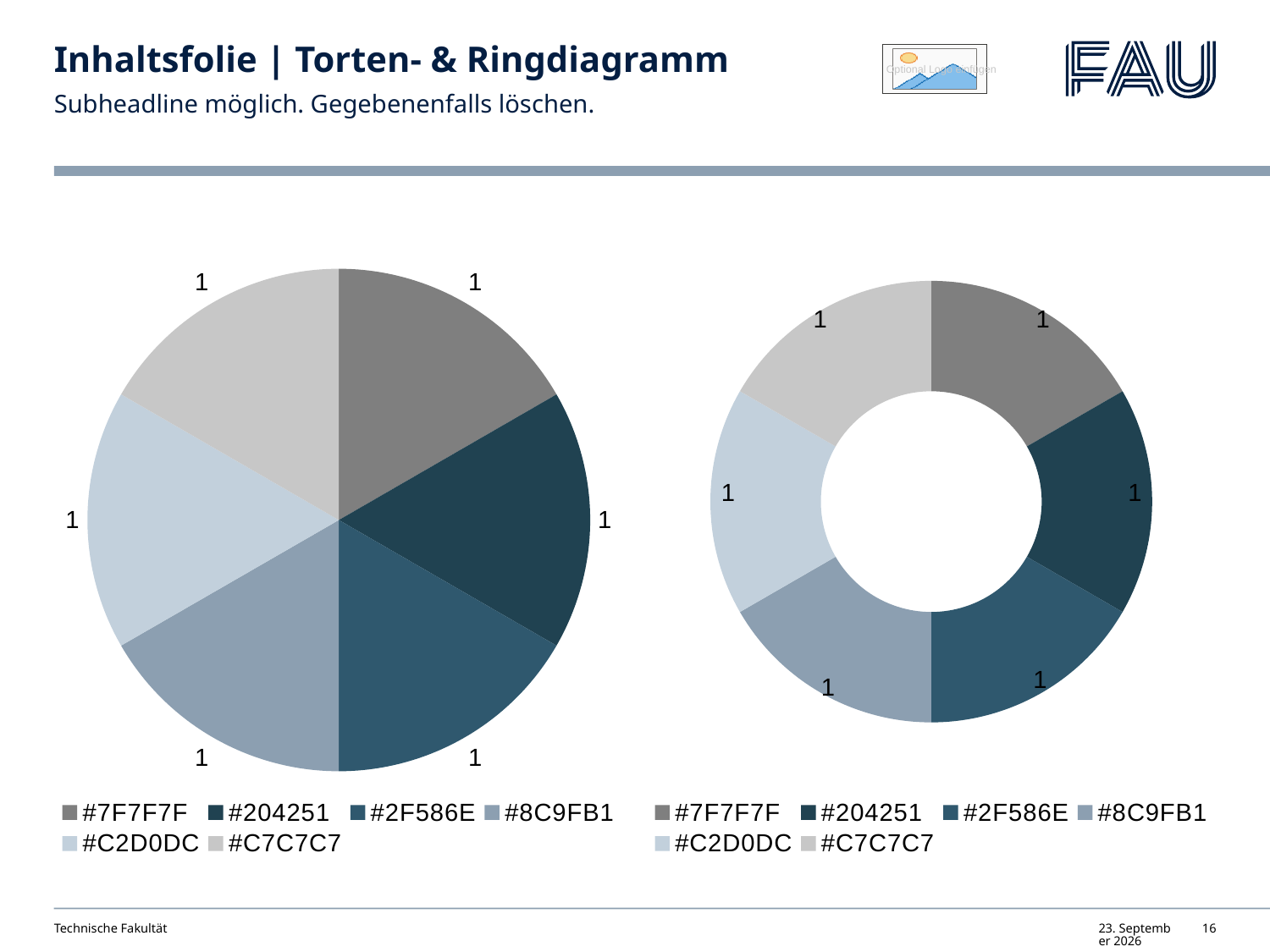
In the pie chart on the left, what is the value of the #204251 slice? 1 What kind of chart is the chart on the right of the slide? doughnut chart In the pie chart on the left, what is the total of all the slice values? 6 What kind of chart is the chart on the left of the slide? pie chart In the pie chart on the left, which legend entry is listed last? #C7C7C7 In the doughnut chart on the right, what is the value of the #C7C7C7 segment? 1 In the pie chart on the left, what is the difference between the values of the #7F7F7F slice and the #C2D0DC slice? 0 In the pie chart on the left, how many slices are there? 6 In the doughnut chart on the right, which legend entry is listed first? #7F7F7F How many entries does the legend of the pie chart on the left list? 6 In the doughnut chart on the right, how many segments are there? 6 In the doughnut chart on the right, what is the total of all the segment values? 6